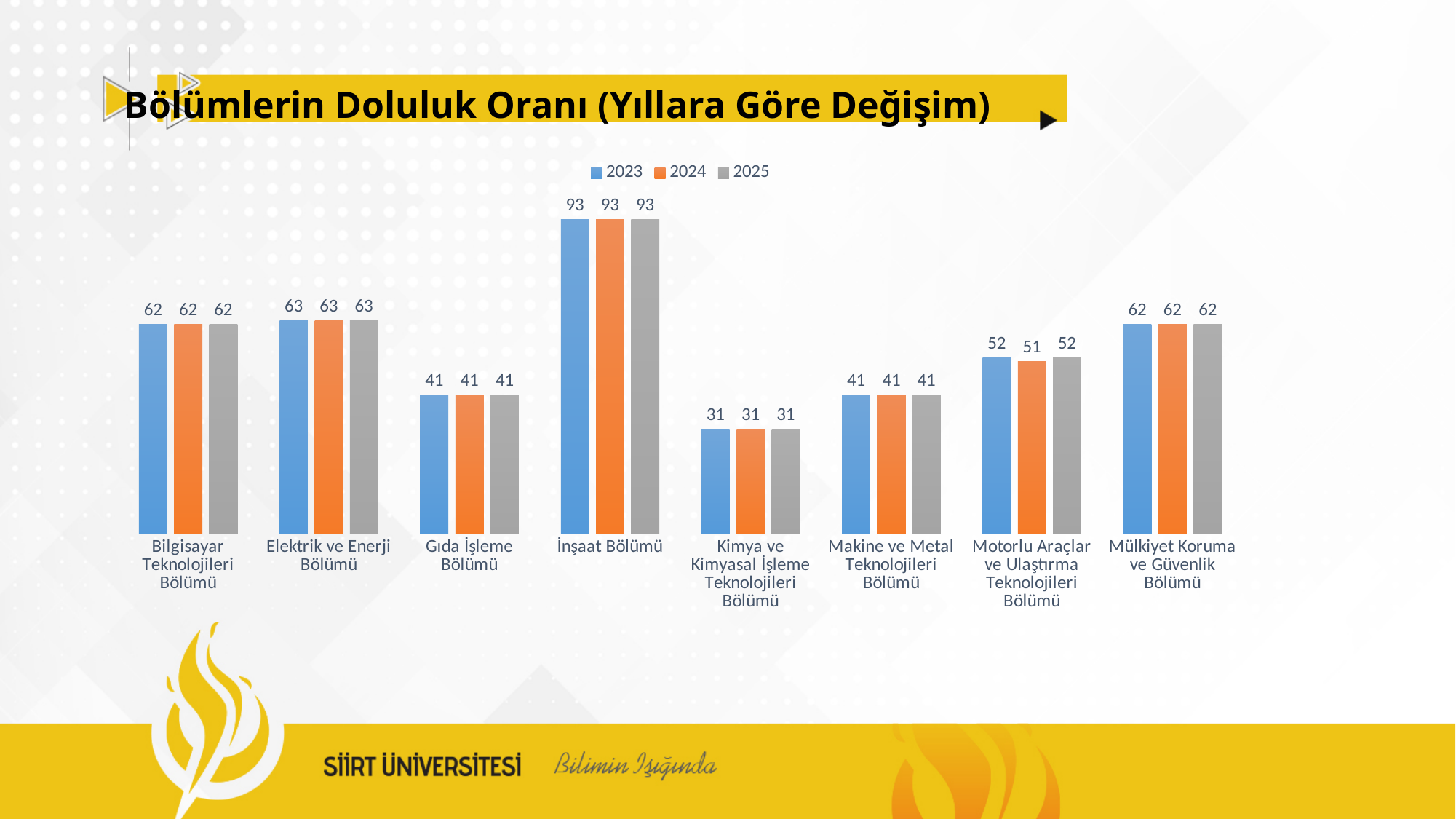
Which department has the highest value in 2025? İnşaat Bölümü Which colour represents the 2024 series in the legend? Orange Which is larger in 2023: Elektrik ve Enerji Bölümü or Makine ve Metal Teknolojileri Bölümü? Elektrik ve Enerji Bölümü How many series does the legend list? 3 What is the value for İnşaat Bölümü in 2023? 93 What is the value for Kimya ve Kimyasal İşleme Teknolojileri Bölümü in 2025? 31 What is the value for Motorlu Araçlar ve Ulaştırma Teknolojileri Bölümü in 2024? 51 What is the difference between the 2024 values for İnşaat Bölümü and Gıda İşleme Bölümü? 52 How many departments are shown on the x axis? 8 What kind of chart is shown on the slide? Bar chart What is the title of the chart? Bölümlerin Doluluk Oranı (Yıllara Göre Değişim) Which department has the lowest value in 2023? Kimya ve Kimyasal İşleme Teknolojileri Bölümü